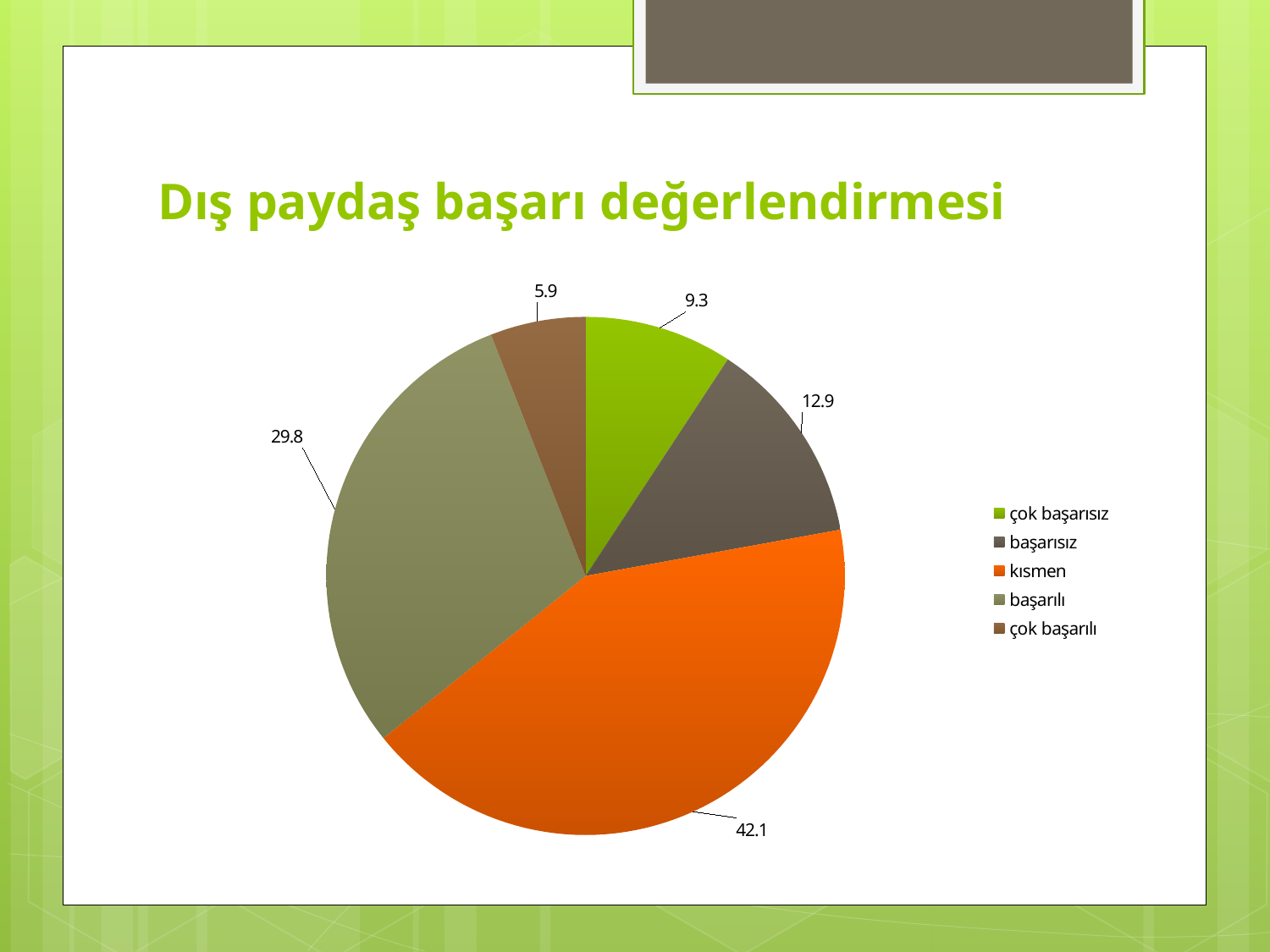
How many categories does the legend list? 5 What colour is the 'kısmen' slice? Orange What is the value for the 'çok başarılı' slice? 5.9 Which is larger, 'başarısız' or 'çok başarısız'? başarısız What is the title of the chart? Dış paydaş başarı değerlendirmesi What is the value for the 'çok başarısız' slice? 9.3 Which category has the largest slice? kısmen What type of chart is shown on the slide? Pie chart Which category has the smallest slice? çok başarılı What is the value for the 'başarılı' slice? 29.8 What is the value for the 'kısmen' slice? 42.1 What is the difference between the 'kısmen' and 'başarılı' values? 12.3